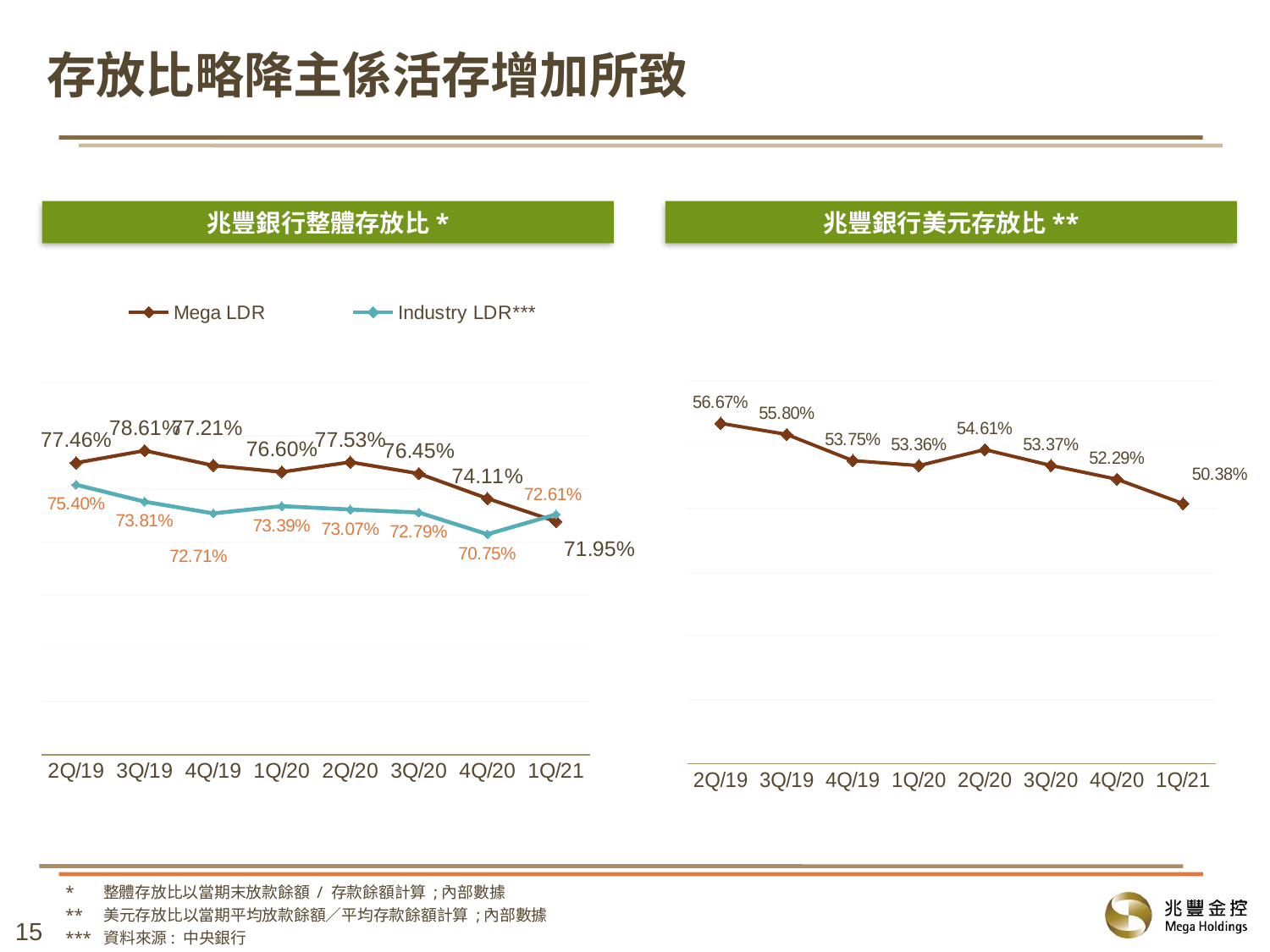
In the left chart (兆豐銀行整體存放比 *), which quarter has the highest Industry LDR*** value? 2Q/19 In the left chart (兆豐銀行整體存放比 *), how many series does the legend list? 2 In the left chart (兆豐銀行整體存放比 *), which is larger in 1Q/21: Mega LDR or Industry LDR***? Industry LDR*** In the right chart (兆豐銀行美元存放比 **), what is the value for 2Q/20? 54.61% In the right chart (兆豐銀行美元存放比 **), how many quarters are plotted on the x axis? 8 In the left chart (兆豐銀行整體存放比 *), what is the difference between Mega LDR and Industry LDR*** in 2Q/19? 2.06% In the left chart (兆豐銀行整體存放比 *), which quarter has the lowest Mega LDR value? 1Q/21 In the left chart (兆豐銀行整體存放比 *), what is the Mega LDR value for 3Q/19? 78.61% In the right chart (兆豐銀行美元存放比 **), which quarter has the highest value? 2Q/19 In the left chart (兆豐銀行整體存放比 *), what is the Industry LDR*** value for 4Q/20? 70.75% What kind of chart is the right chart (兆豐銀行美元存放比 **)? Line chart In the right chart (兆豐銀行美元存放比 **), what is the difference between the 2Q/19 and 1Q/21 values? 6.29%